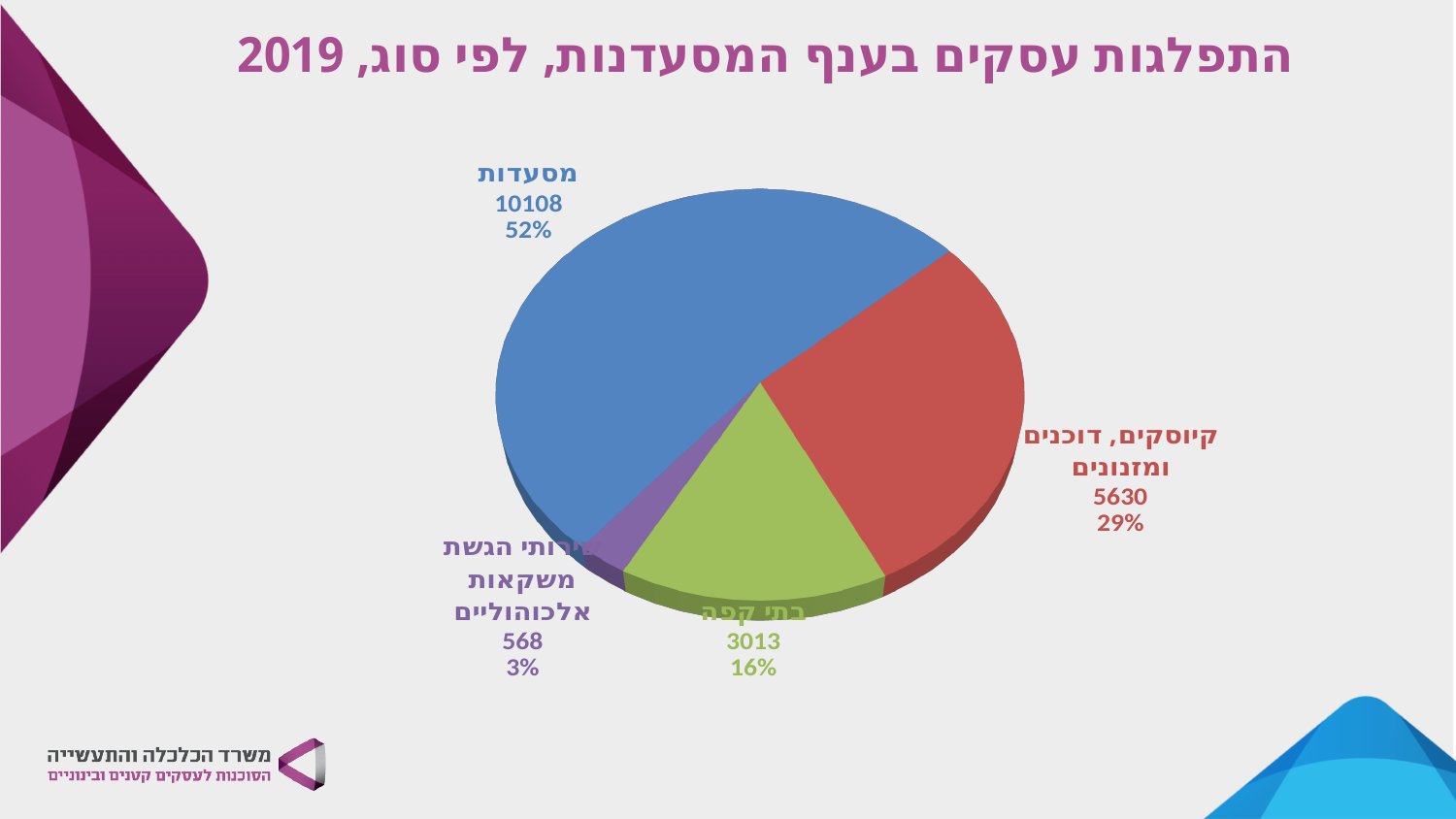
Which is larger, the value for בתי קפה or the value for קיוסקים, דוכנים ומזנונים? קיוסקים, דוכנים ומזנונים What percentage share does the מסעדות slice have? 52% What is the value shown for שירותי הגשת משקאות אלכוהוליים? 568 What is the value shown for קיוסקים, דוכנים ומזנונים? 5630 What kind of chart is shown on the slide? Pie chart Which category has the largest slice of the pie? מסעדות What is the value shown for מסעדות? 10108 What is the difference between the values for מסעדות and קיוסקים, דוכנים ומזנונים? 4478 How many slices does the pie chart have? 4 Which category has the smallest slice of the pie? שירותי הגשת משקאות אלכוהוליים What percentage share does the בתי קפה slice have? 16% What is the title of the chart? התפלגות עסקים בענף המסעדנות, לפי סוג, 2019